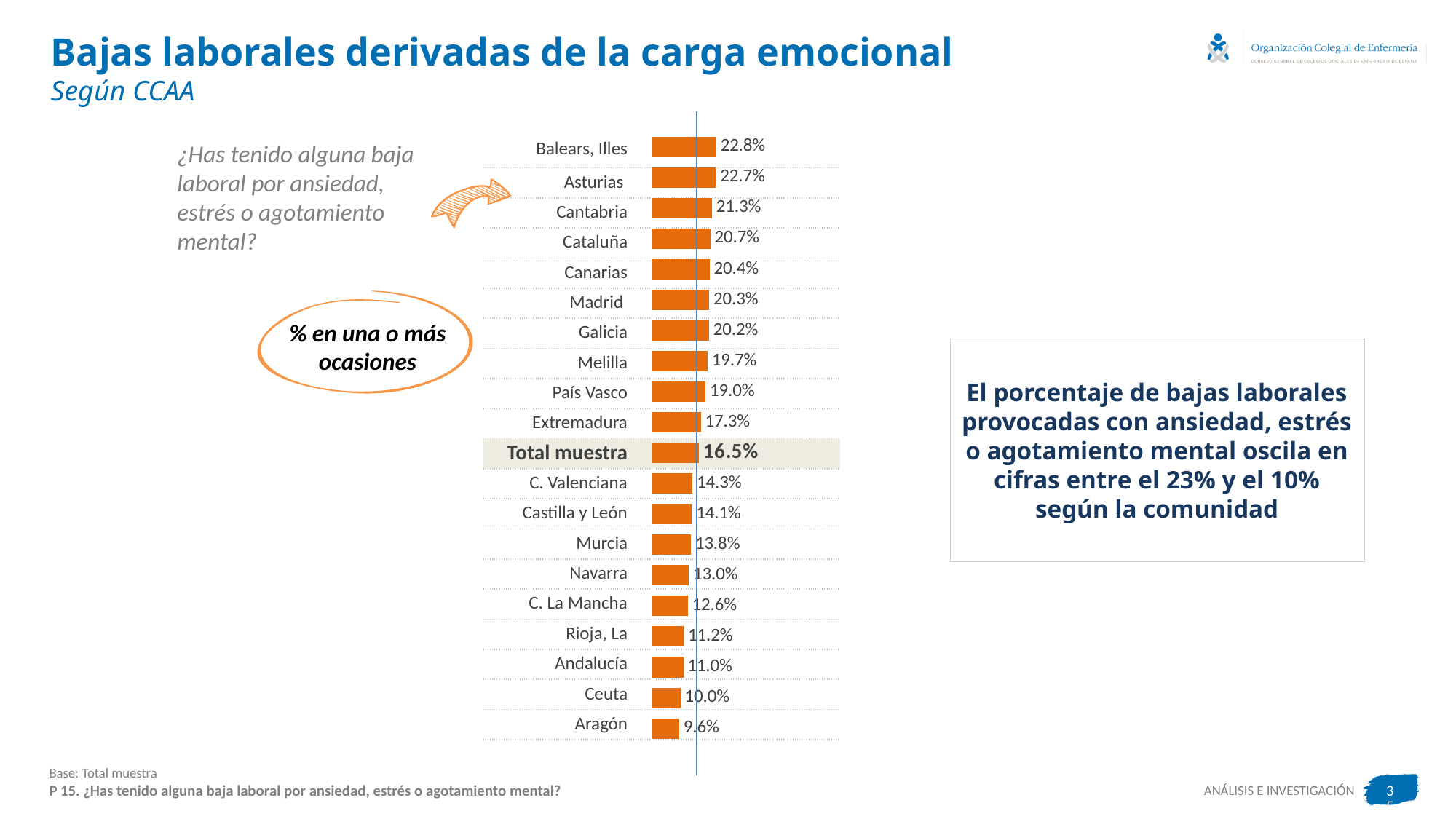
Which is larger, the value for Extremadura or the value for C. Valenciana? Extremadura What colour are the bars in the chart? Orange Which category has the lowest value? Aragón What is the value for Balears, Illes? 22.8% What is the value for Total muestra? 16.5% What kind of chart is shown on the slide? Bar chart What is the value for Castilla y León? 14.1% How many categories (bars) are shown in the chart? 20 Which category has the highest value? Balears, Illes What is the difference between the values for Balears, Illes and Aragón? 13.2% Which is larger, the value for Cantabria or the value for Navarra? Cantabria What is the difference between the values for Madrid and Murcia? 6.5%